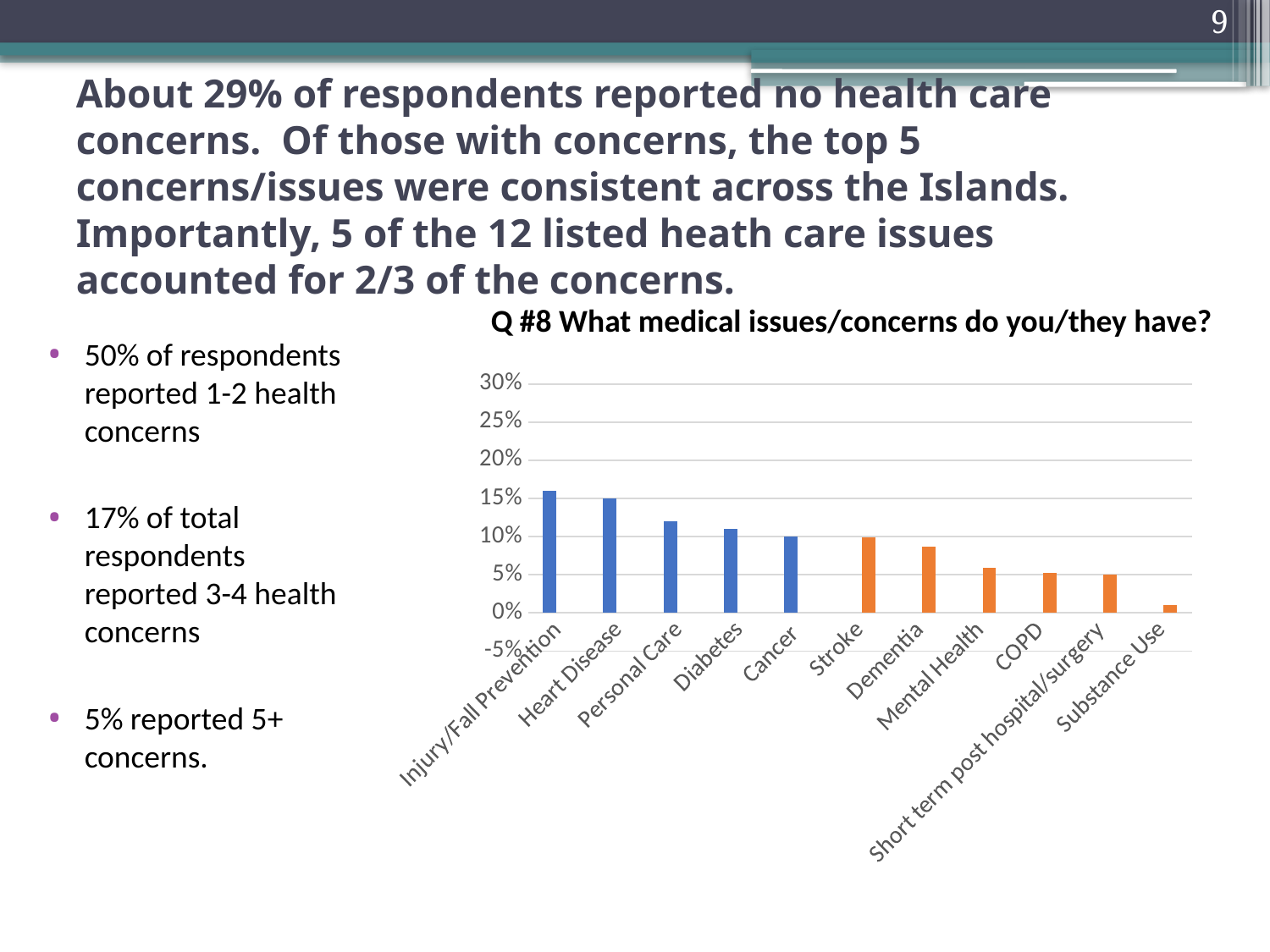
Is the value for Personal Care greater or less than 10%? greater Is the value for Mental Health greater or less than 10%? less Do the values rise or fall moving from left to right along the x axis? fall How many bars in the chart are coloured orange? 6 Which is larger, the value for Heart Disease or the value for Dementia? Heart Disease What is the title of the chart? Q #8 What medical issues/concerns do you/they have? Is the value for Substance Use greater or less than 5%? less What kind of chart is shown on the slide? bar chart Which category has the lowest value in the chart? Substance Use Which category has the highest value in the chart? Injury/Fall Prevention How many medical issue categories are shown on the x axis of the chart? 11